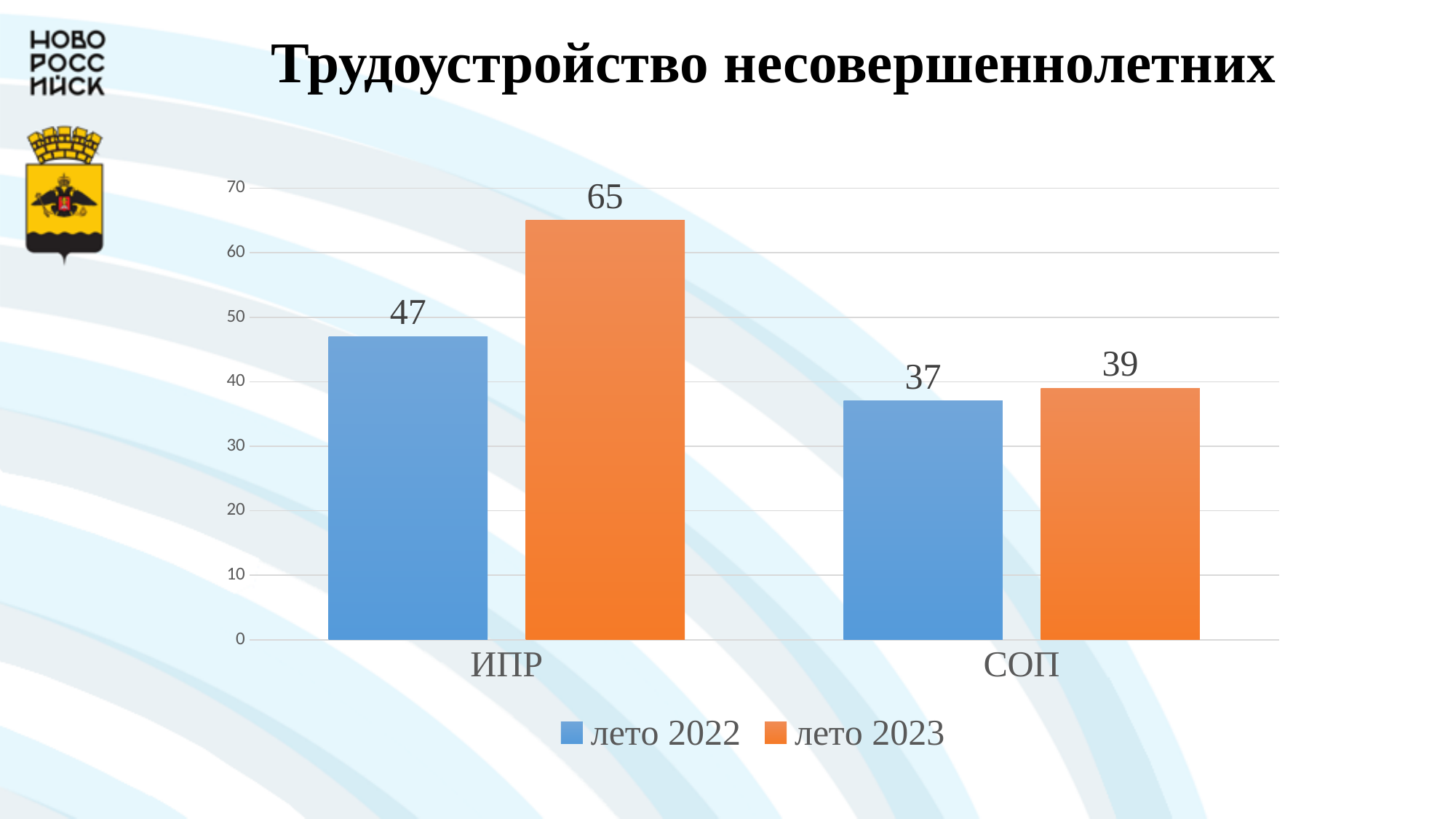
What is the value for ИПР in лето 2023? 65 How many categories are shown on the x axis? 2 How many series does the legend list? 2 What is the difference between the лето 2023 and лето 2022 values for ИПР? 18 What kind of chart is shown on the slide? bar chart What is the value for СОП in лето 2022? 37 What is the value for ИПР in лето 2022? 47 Which category has the highest value in лето 2023? ИПР What is the value for СОП in лето 2023? 39 What is the title of the slide? Трудоустройство несовершеннолетних Which category has the lowest value in лето 2022? СОП Which is larger for СОП: лето 2022 or лето 2023? лето 2023